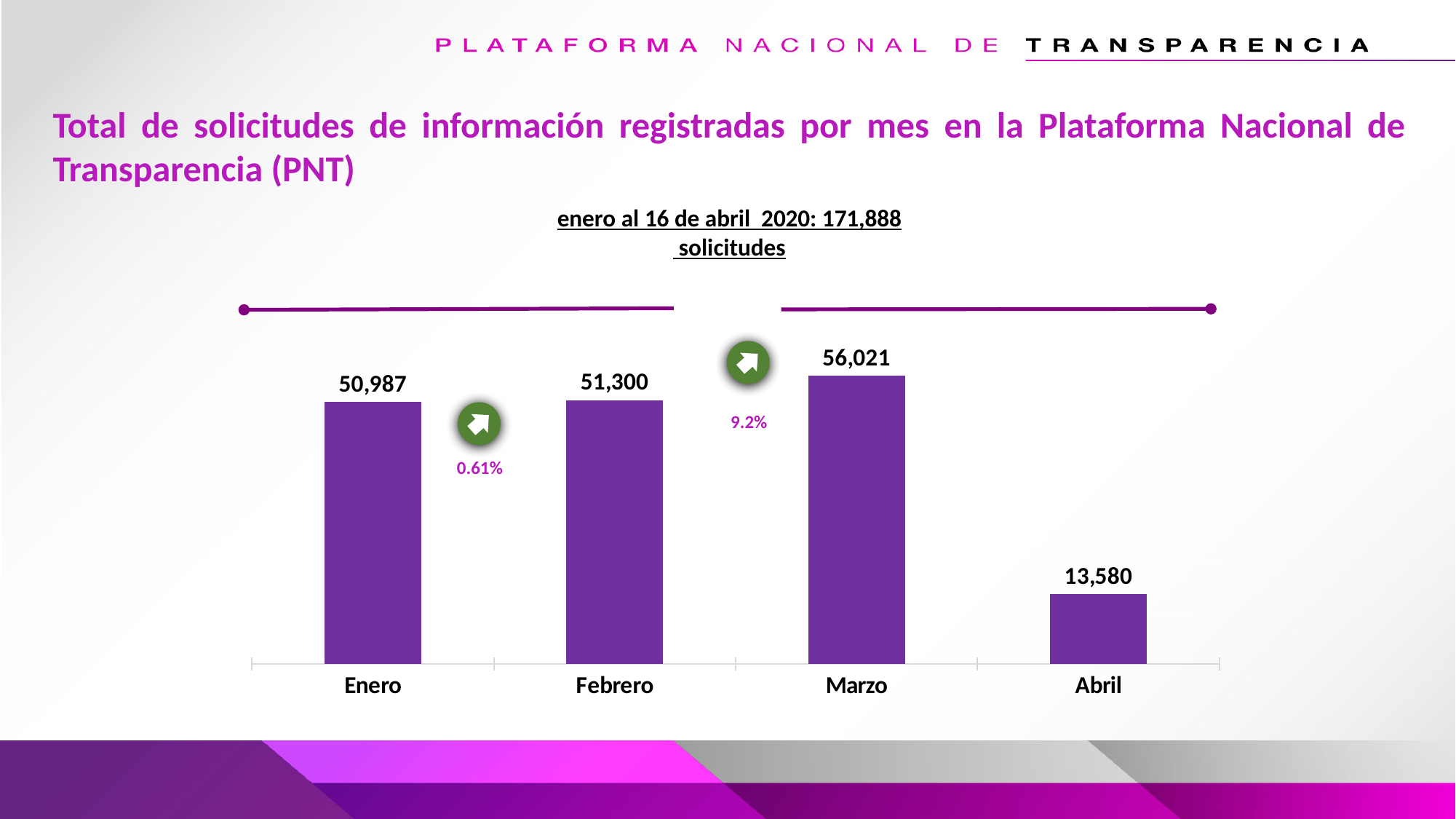
What kind of chart is shown on the slide? Bar chart What is the difference between the values for Enero and Abril? 37,407 What is the value for Abril? 13,580 What is the value for Marzo? 56,021 Which month has the highest value? Marzo How many months are shown on the chart? 4 What is the difference between the values for Marzo and Febrero? 4,721 What is the value for Enero? 50,987 What percentage increase is shown between Febrero and Marzo? 9.2% Which is larger, the value for Enero or the value for Febrero? Febrero What is the value for Febrero? 51,300 Which month has the lowest value? Abril